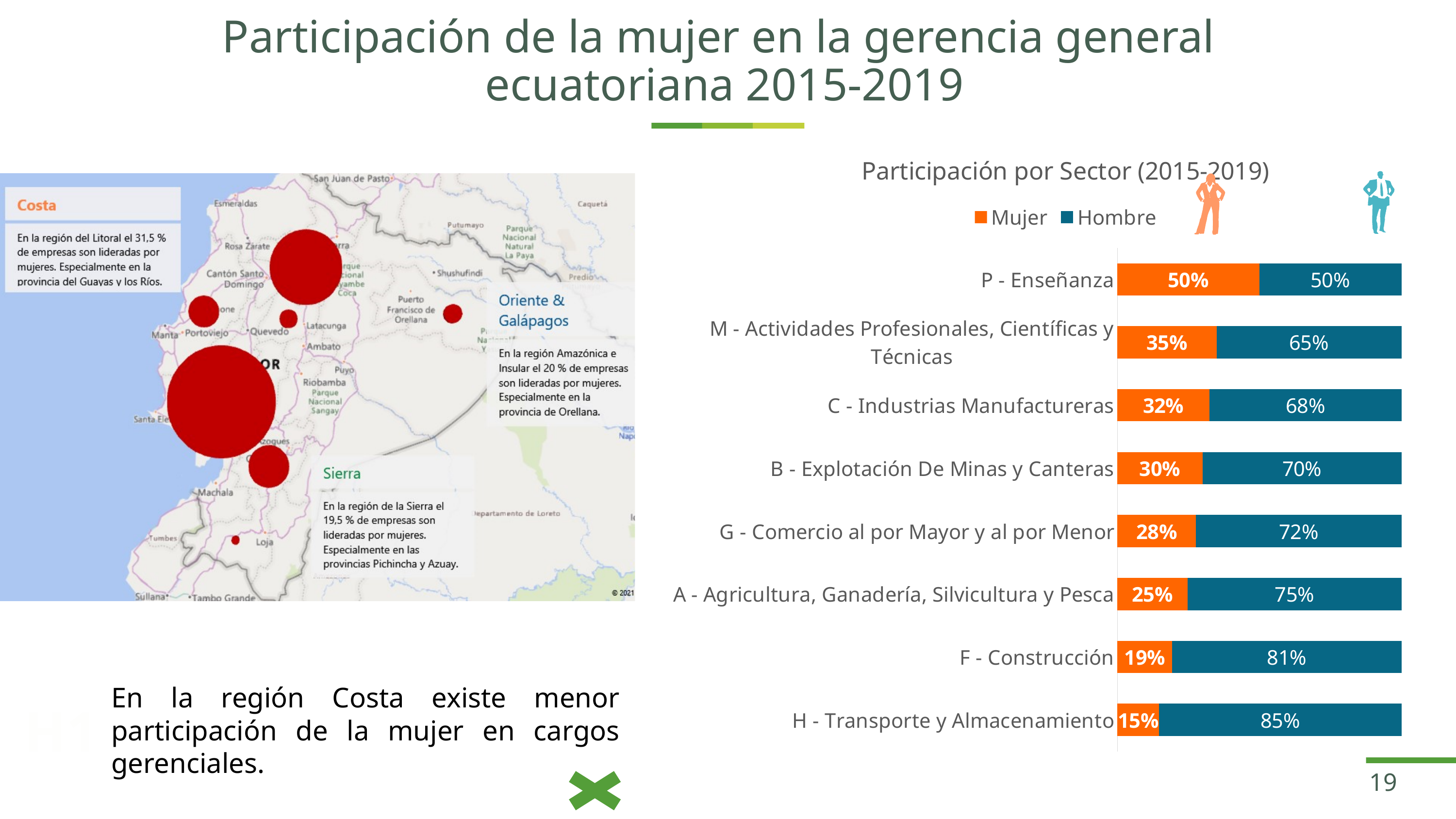
In the 'Participación por Sector (2015-2019)' chart, which sector has the lowest Mujer value? H - Transporte y Almacenamiento In the 'Participación por Sector (2015-2019)' chart, which sector has the highest Hombre value? H - Transporte y Almacenamiento In the 'Participación por Sector (2015-2019)' chart, which sector has the highest Mujer value? P - Enseñanza In the 'Participación por Sector (2015-2019)' chart, what is the Mujer value for C - Industrias Manufactureras? 32% How many series does the legend of the 'Participación por Sector (2015-2019)' chart list? 2 What type of chart is 'Participación por Sector (2015-2019)'? Stacked bar chart How many sectors are shown in the 'Participación por Sector (2015-2019)' chart? 8 In the 'Participación por Sector (2015-2019)' chart, what is the Hombre value for F - Construcción? 81% In the 'Participación por Sector (2015-2019)' chart, which is larger: the Mujer value for A - Agricultura, Ganadería, Silvicultura y Pesca or the Mujer value for F - Construcción? A - Agricultura, Ganadería, Silvicultura y Pesca In the 'Participación por Sector (2015-2019)' chart, what is the difference between the Mujer values for M - Actividades Profesionales, Científicas y Técnicas and B - Explotación De Minas y Canteras? 5% In the 'Participación por Sector (2015-2019)' chart, what is the Mujer value for P - Enseñanza? 50% In the 'Participación por Sector (2015-2019)' chart, what is the difference between the Hombre and Mujer values for G - Comercio al por Mayor y al por Menor? 44%